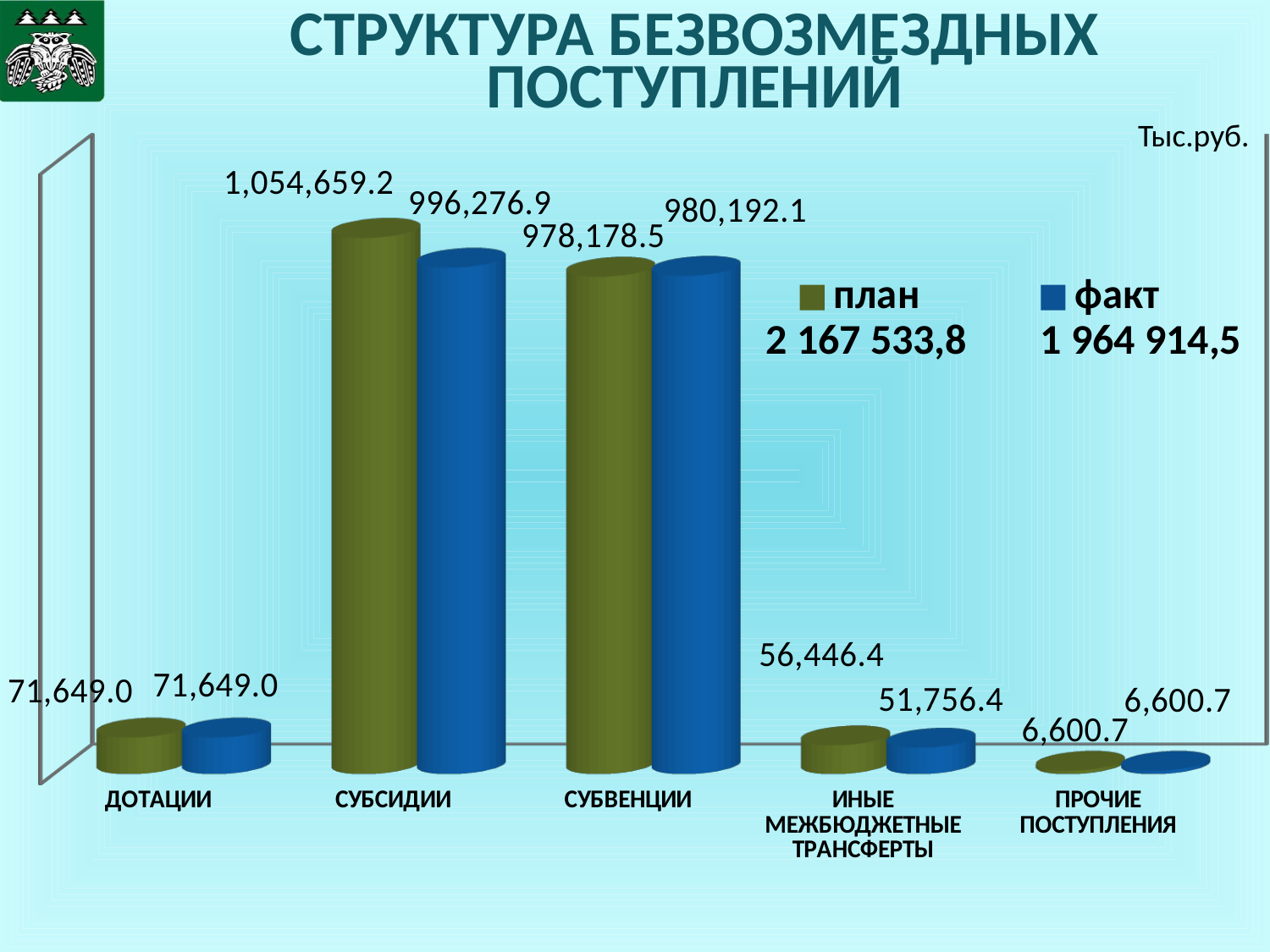
What is the difference between the план and факт values for ИНЫЕ МЕЖБЮДЖЕТНЫЕ ТРАНСФЕРТЫ? 4,690.0 What is the план value for ДОТАЦИИ? 71,649.0 What is the план value for СУБСИДИИ? 1,054,659.2 For СУБВЕНЦИИ, which is larger: the план value or the факт value? факт Which category has the highest план value? СУБСИДИИ What is the факт value for ИНЫЕ МЕЖБЮДЖЕТНЫЕ ТРАНСФЕРТЫ? 51,756.4 Which category has the lowest факт value? ПРОЧИЕ ПОСТУПЛЕНИЯ What is the факт value for СУБВЕНЦИИ? 980,192.1 How many series does the legend list? 2 What is the difference between the план and факт values for СУБСИДИИ? 58,382.3 What kind of chart is shown on the slide? Bar chart How many categories are shown on the x axis? 5